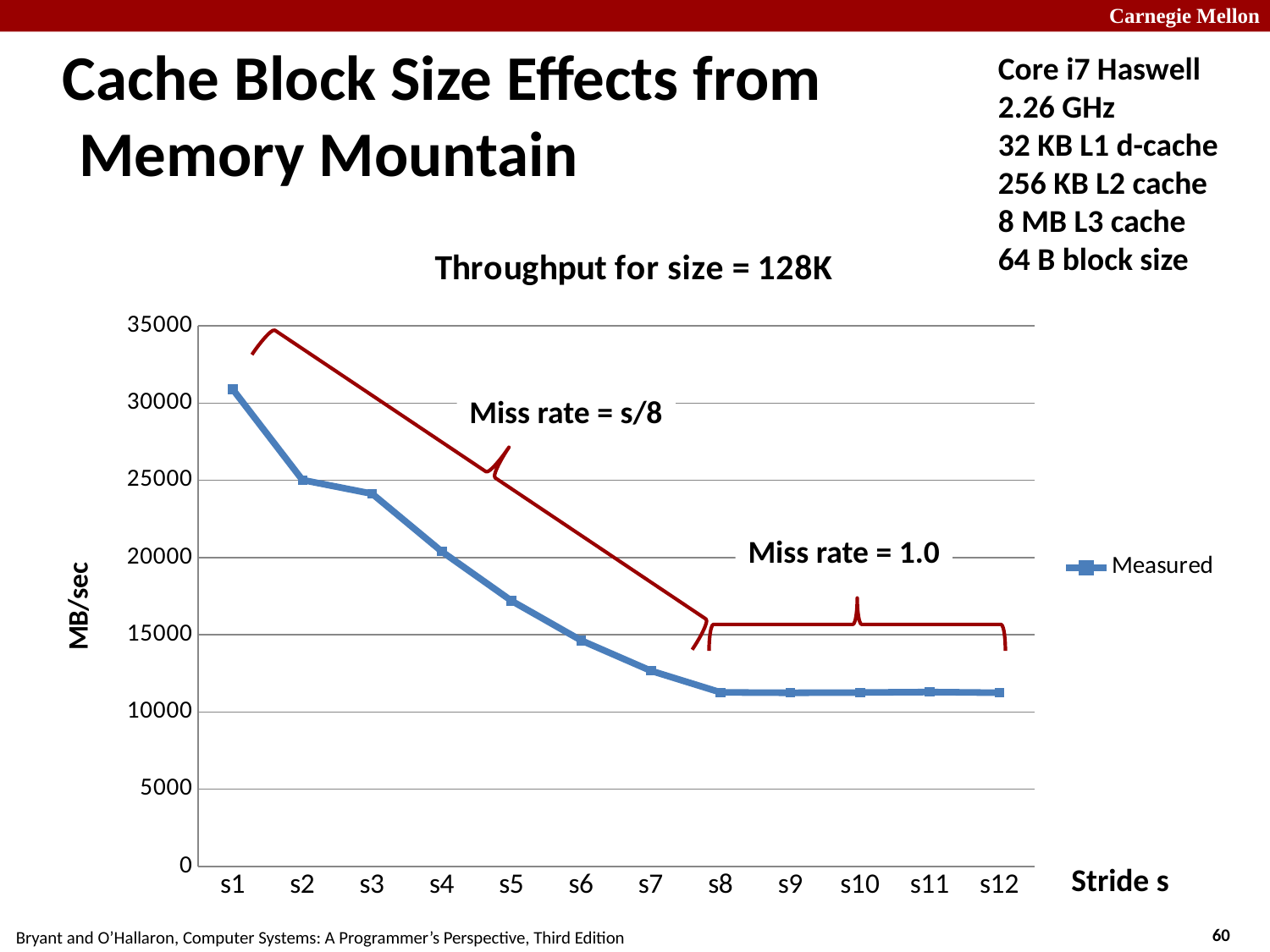
Is the measured value for s7 greater or less than 15000? less How many stride values are plotted along the x axis? 12 Which stride has the highest measured throughput? s1 Is the measured value for s1 greater or less than 30000? greater Is the measured value for s12 greater or less than 10000? greater What is the name of the series in the legend? Measured What is the title of the chart? Throughput for size = 128K Which has the larger measured throughput, s2 or s7? s2 How many series does the legend list? 1 What kind of chart is shown on the slide? line chart Do the measured values rise or fall as the stride increases from s1 to s8? fall